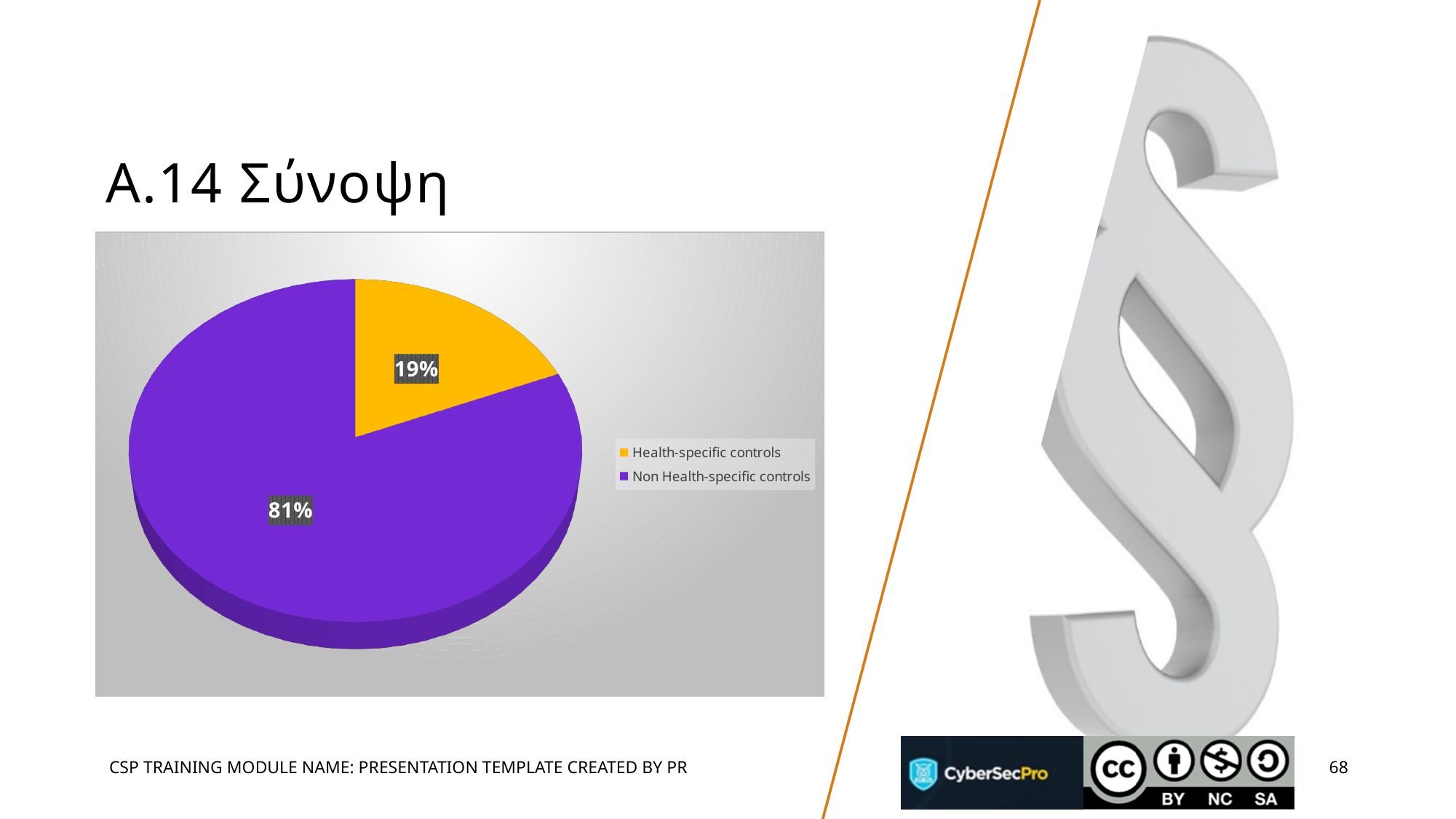
How many slices does the pie chart have? 2 How many entries does the legend list? 2 Which category has the smallest slice of the pie? Health-specific controls What colour is the slice for Non Health-specific controls? purple What share of the pie is Health-specific controls? 19% Which is larger, the slice for Health-specific controls or the slice for Non Health-specific controls? Non Health-specific controls What share of the pie is Non Health-specific controls? 81% Which category has the largest slice of the pie? Non Health-specific controls What is the difference in percentage points between Non Health-specific controls and Health-specific controls? 62 What colour is the slice for Health-specific controls? yellow What kind of chart is shown on the slide? pie chart